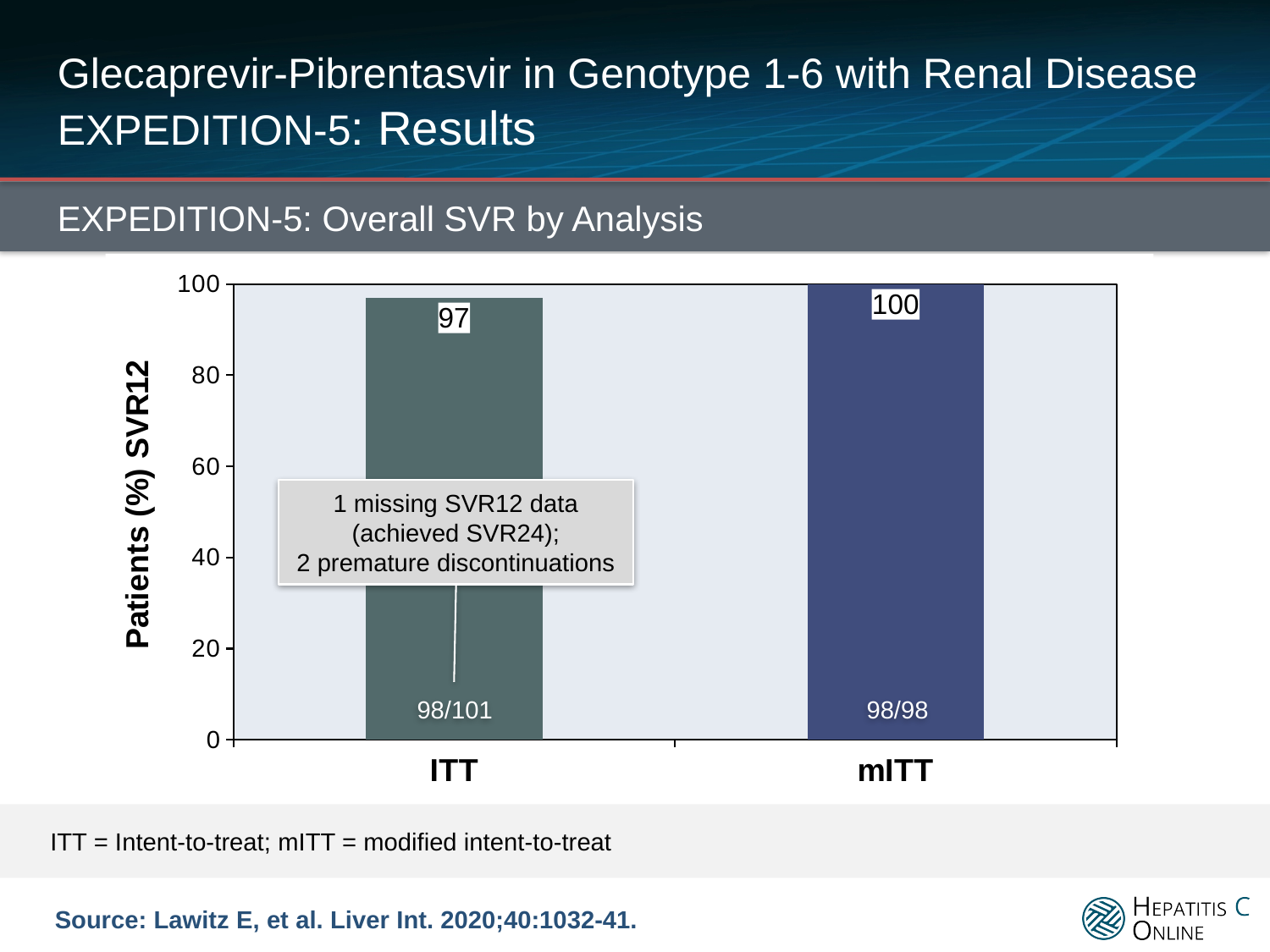
What fraction of patients is printed on the mITT bar? 98/98 Is the SVR12 value for ITT greater or less than 80? greater What is the title of the chart? EXPEDITION-5: Overall SVR by Analysis How many categories are shown on the x axis? 2 Which analysis has the higher SVR12 rate? mITT What is the SVR12 value for mITT? 100 What is the SVR12 value for ITT? 97 What fraction of patients is printed on the ITT bar? 98/101 What kind of chart is shown? bar chart What is the y-axis label of the chart? Patients (%) SVR12 Which analysis has the lower SVR12 rate? ITT What is the difference in SVR12 between mITT and ITT? 3